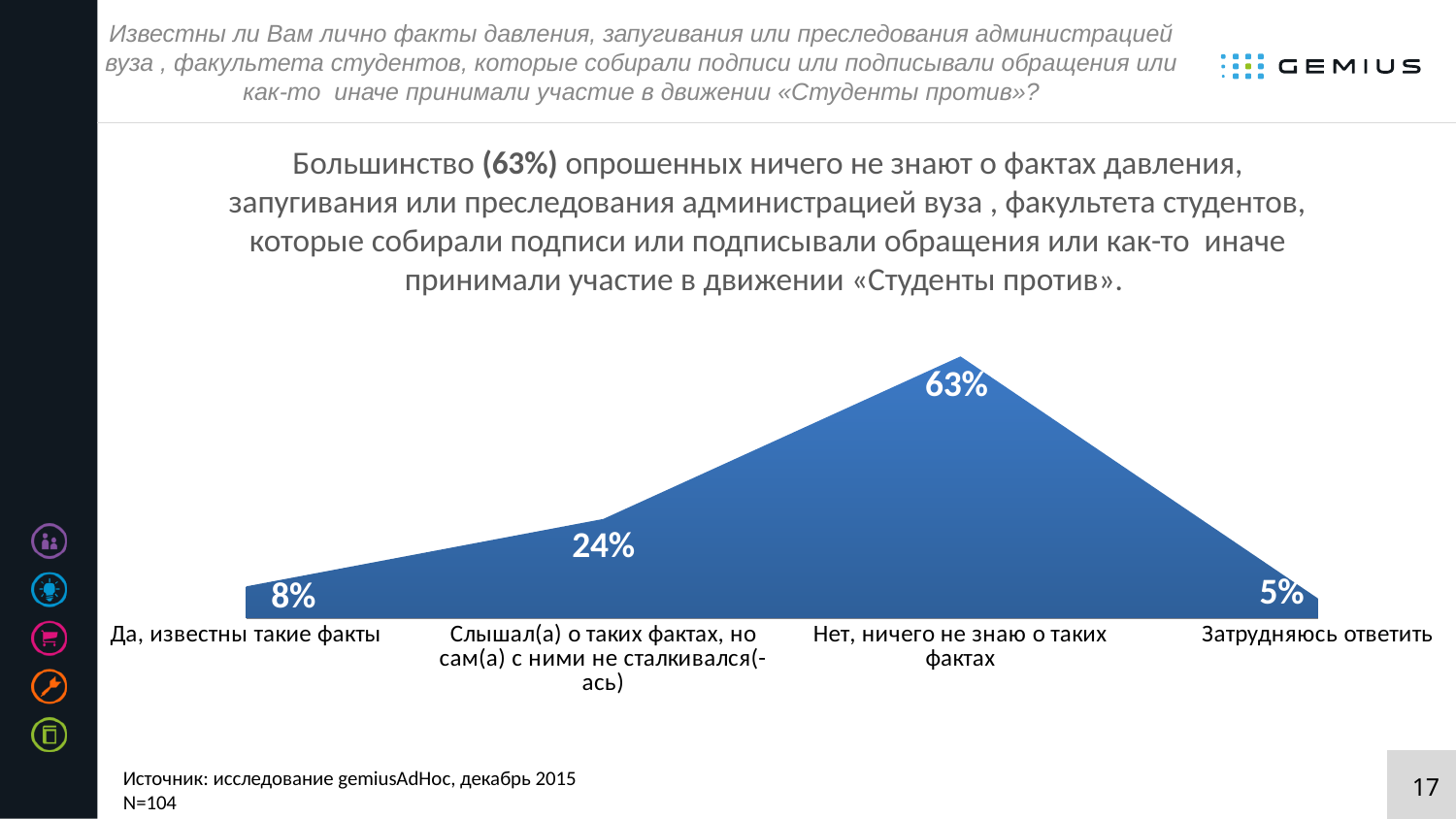
What percentage is shown for "Слышал(а) о таких фактах, но сам(а) с ними не сталкивался(-ась)"? 24% How many categories are shown on the chart? 4 What is the difference between the values for "Нет, ничего не знаю о таких фактах" and "Слышал(а) о таких фактах, но сам(а) с ними не сталкивался(-ась)"? 39% What is the difference between the values for "Да, известны такие факты" and "Затрудняюсь ответить"? 3% What is the sample size (N) stated on the slide? N=104 Which category has the highest value? Нет, ничего не знаю о таких фактах What percentage of respondents answered "Нет, ничего не знаю о таких фактах"? 63% Which category has the lowest value? Затрудняюсь ответить What type of chart is shown on the slide? Area chart What value is shown for "Затрудняюсь ответить"? 5% Which is larger: the value for "Да, известны такие факты" or the value for "Слышал(а) о таких фактах, но сам(а) с ними не сталкивался(-ась)"? Слышал(а) о таких фактах, но сам(а) с ними не сталкивался(-ась) What value is shown for "Да, известны такие факты"? 8%